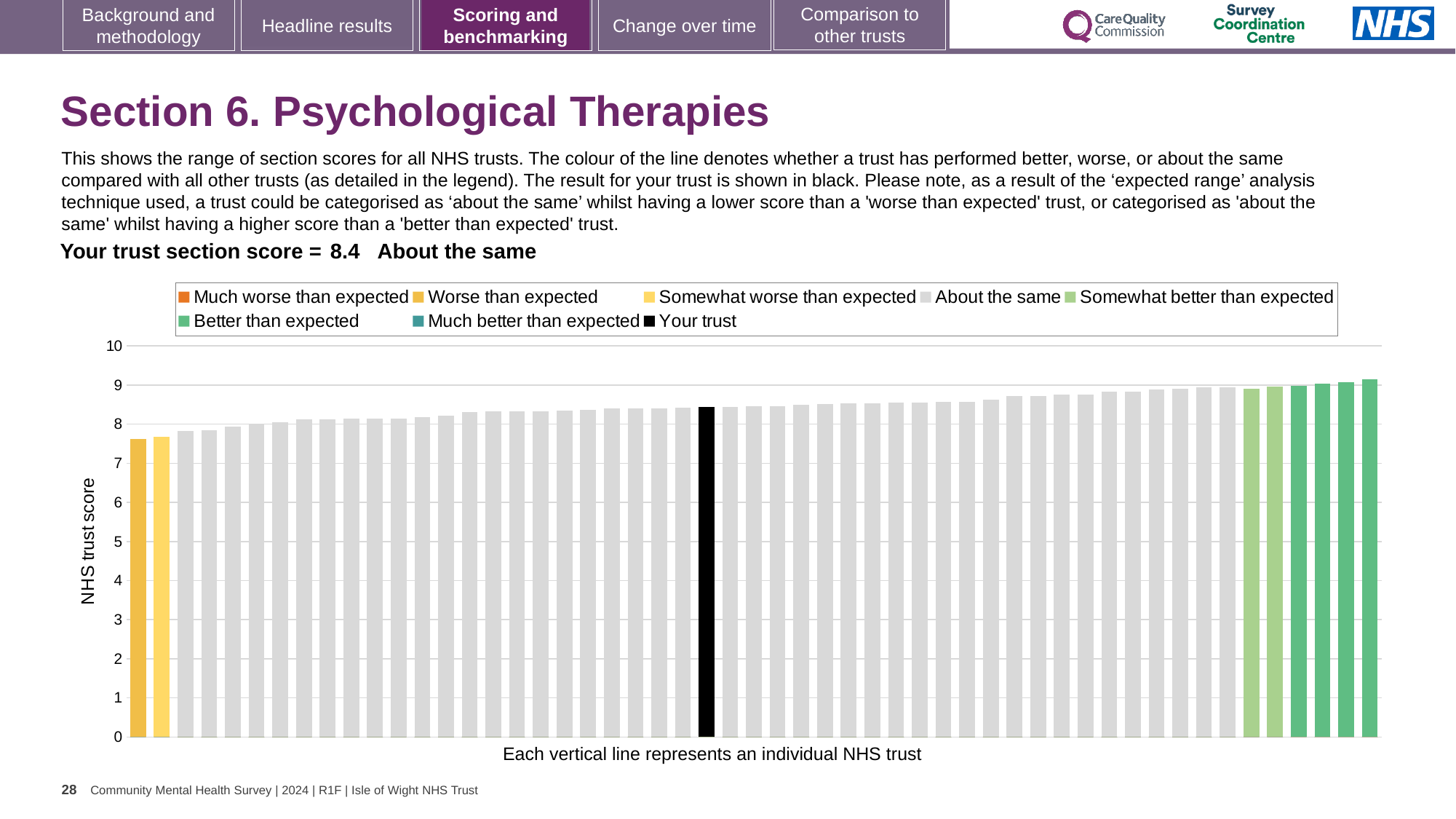
Do the bar values rise or fall moving from left to right along the x axis? rise Is the value of the leftmost (lowest) bar greater or less than 8? less Which legend category do the highest-scoring trusts on the right of the chart belong to? Better than expected Is the value for your trust (the black bar) greater or less than 8? greater What kind of chart is shown on the slide? bar chart How many entries does the chart legend list? 8 How many bars are coloured as 'Much worse than expected'? 0 What colour is the bar representing your trust? black What is the section score for your trust shown on the slide? 8.4 Is the value for your trust (the black bar) greater or less than 9? less What is the label on the vertical axis of the chart? NHS trust score